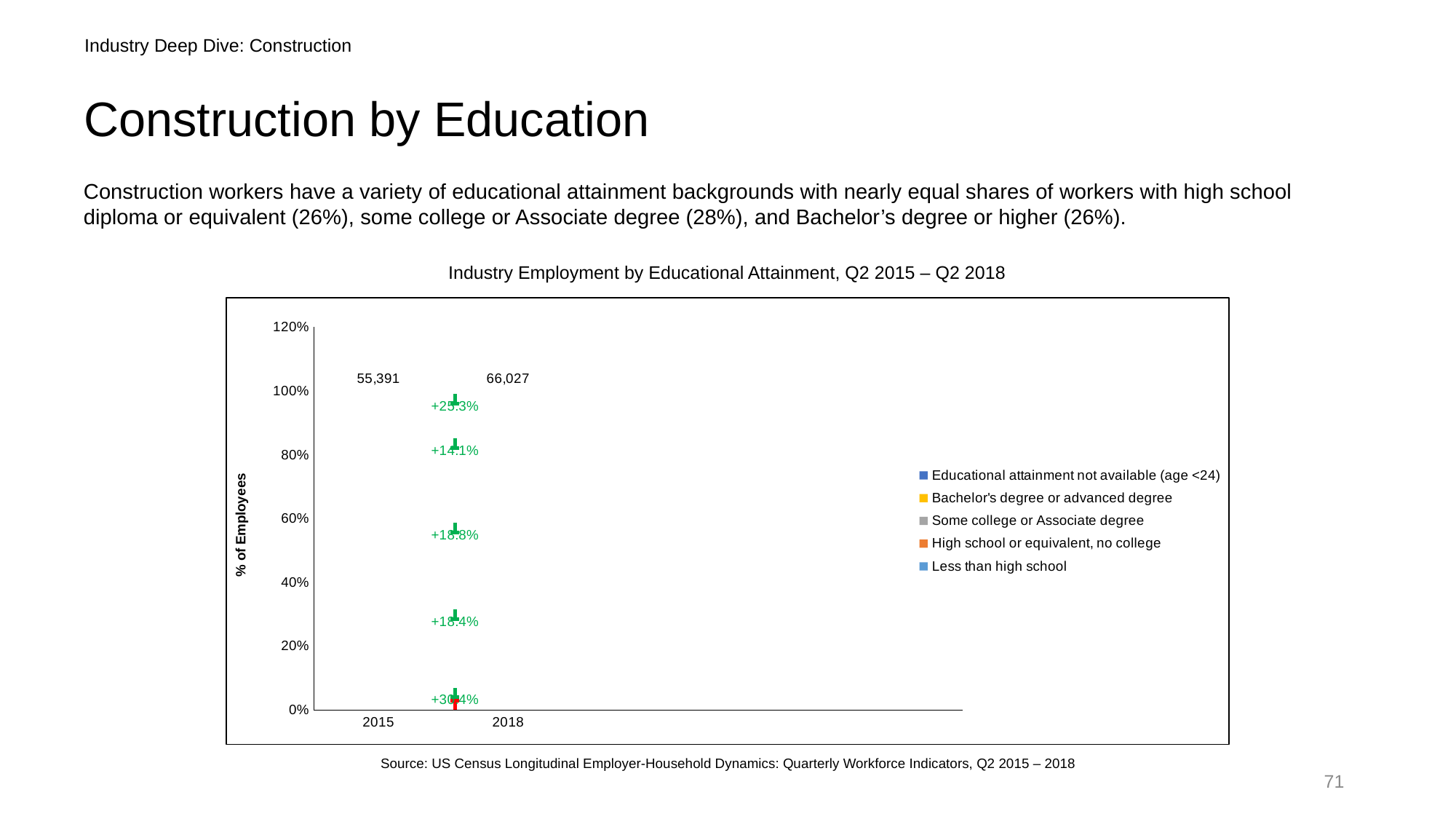
What is the title of the chart? Industry Employment by Educational Attainment, Q2 2015 – Q2 2018 What is the label on the y axis of the chart? % of Employees How many years are shown on the x axis of the chart? 2 What is the difference between the total employment figures printed for 2018 and 2015? 10,636 What is the smallest percentage change label shown between the 2015 and 2018 columns? +14.1% What total employment figure is printed above the 2018 column? 66,027 What is the largest percentage change label shown between the 2015 and 2018 columns? +30.4% What total employment figure is printed above the 2015 column? 55,391 Which year has the larger total employment figure printed on the chart, 2015 or 2018? 2018 How many series does the chart's legend list? 5 How many percentage change labels are shown between the 2015 and 2018 columns? 5